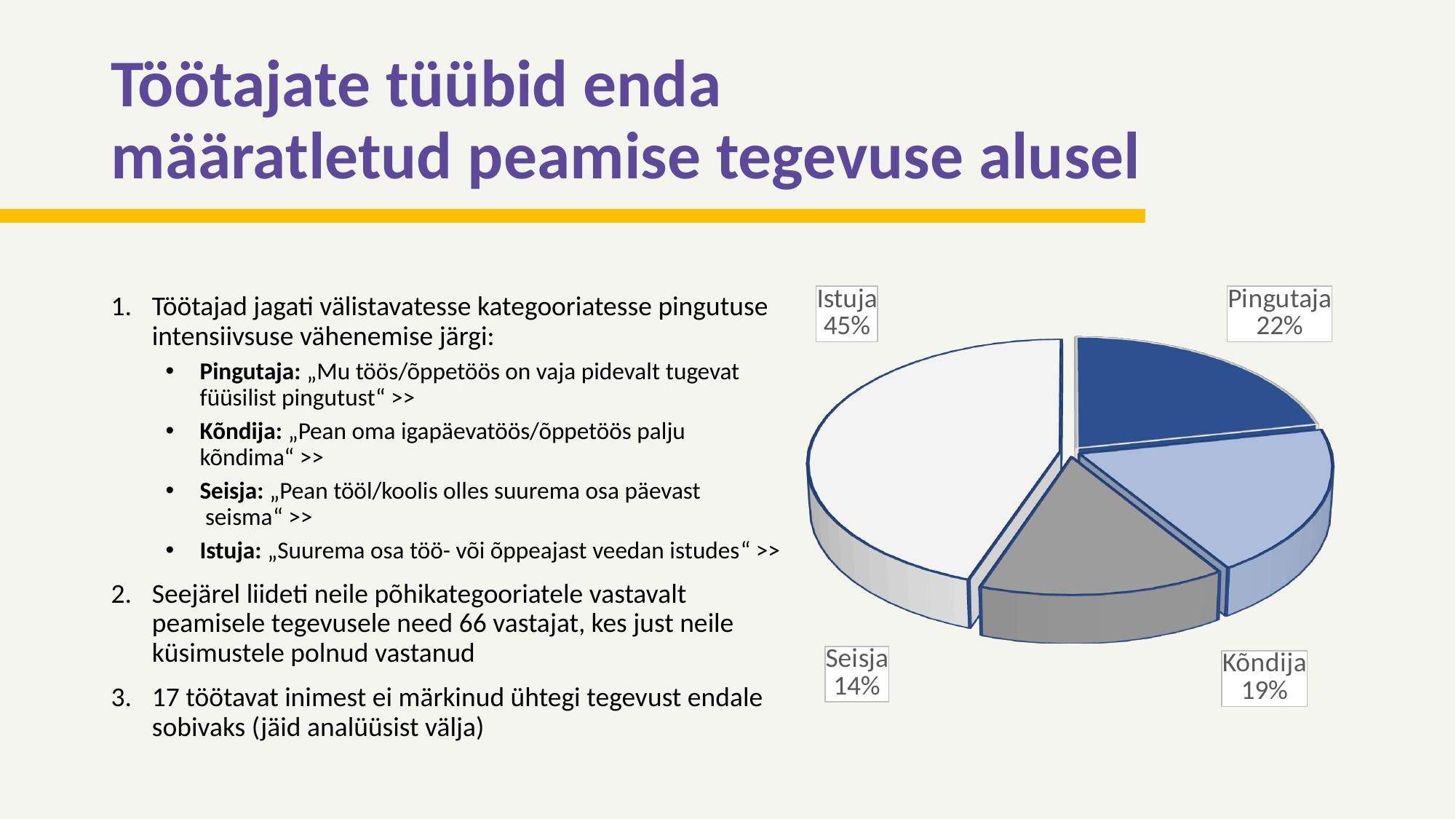
What share of the pie does Seisja have? 14% What share of the pie does Istuja have? 45% What kind of chart is shown on the slide? Pie chart What is the difference in percentage points between Kõndija and Seisja? 5 What share of the pie does Pingutaja have? 22% Which is larger, the share for Pingutaja or the share for Kõndija? Pingutaja What colour is the Pingutaja slice? Dark blue What is the difference in percentage points between Istuja and Pingutaja? 23 What share of the pie does Kõndija have? 19% Which category has the smallest slice of the pie? Seisja Which category has the largest slice of the pie? Istuja How many categories are shown in the pie chart? 4